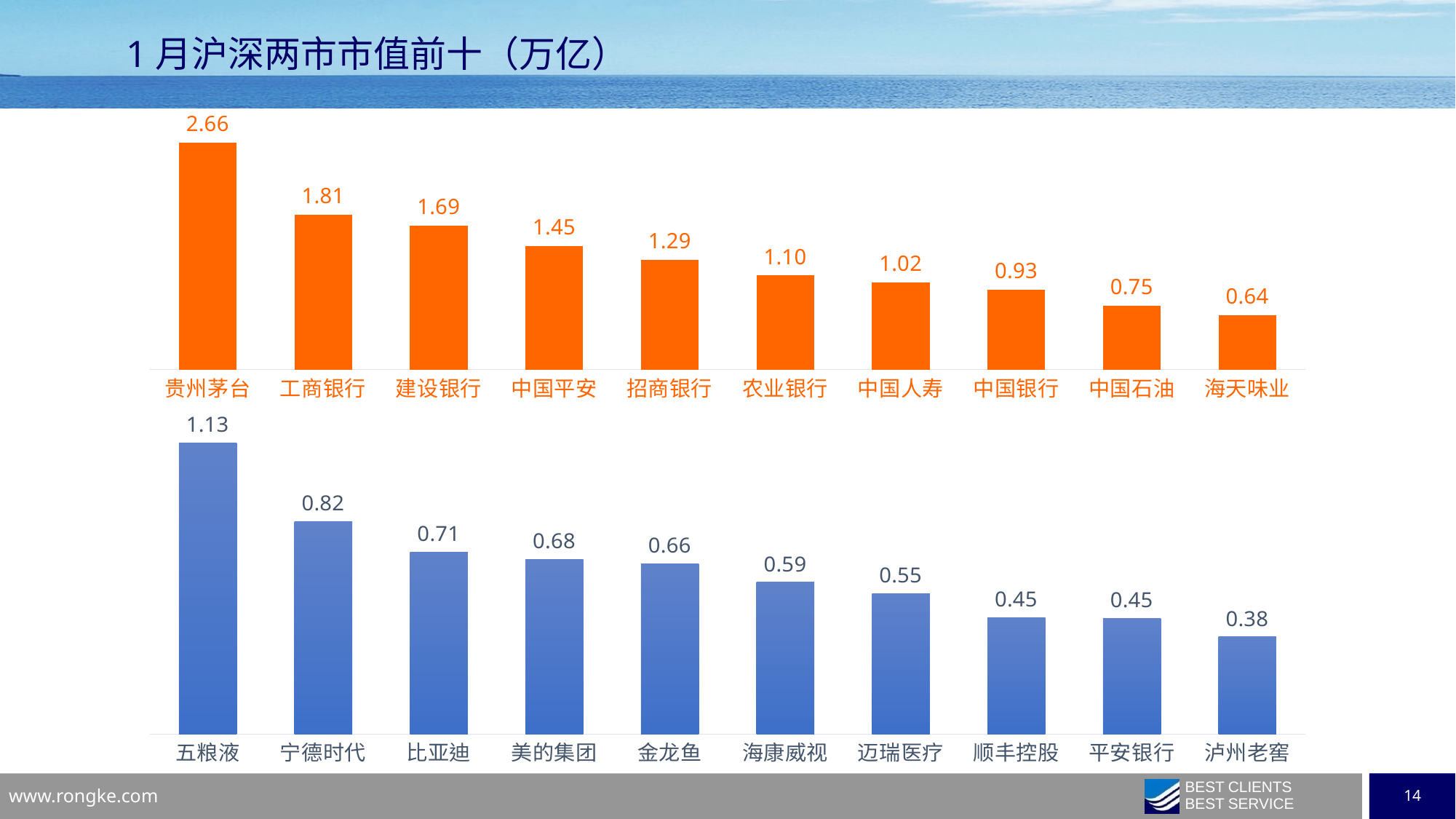
In the bottom (blue) chart, do the values rise or fall from left to right? Fall In the bottom (blue) chart, what is the value for 海康威视? 0.59 In the top (orange) chart, what is the value for 贵州茅台? 2.66 How many categories are shown in the bottom (blue) chart? 10 What type of chart is the top (orange) chart? Bar chart In the top (orange) chart, which category has the lowest value? 海天味业 Which is larger: the value for 中国石油 in the top chart or the value for 比亚迪 in the bottom chart? 中国石油 In the top (orange) chart, what is the value for 招商银行? 1.29 In the top (orange) chart, what is the difference between the values for 工商银行 and 建设银行? 0.12 In the bottom (blue) chart, what is the difference between the values for 五粮液 and 泸州老窖? 0.75 In the bottom (blue) chart, what is the value for 宁德时代? 0.82 In the bottom (blue) chart, which category has the highest value? 五粮液